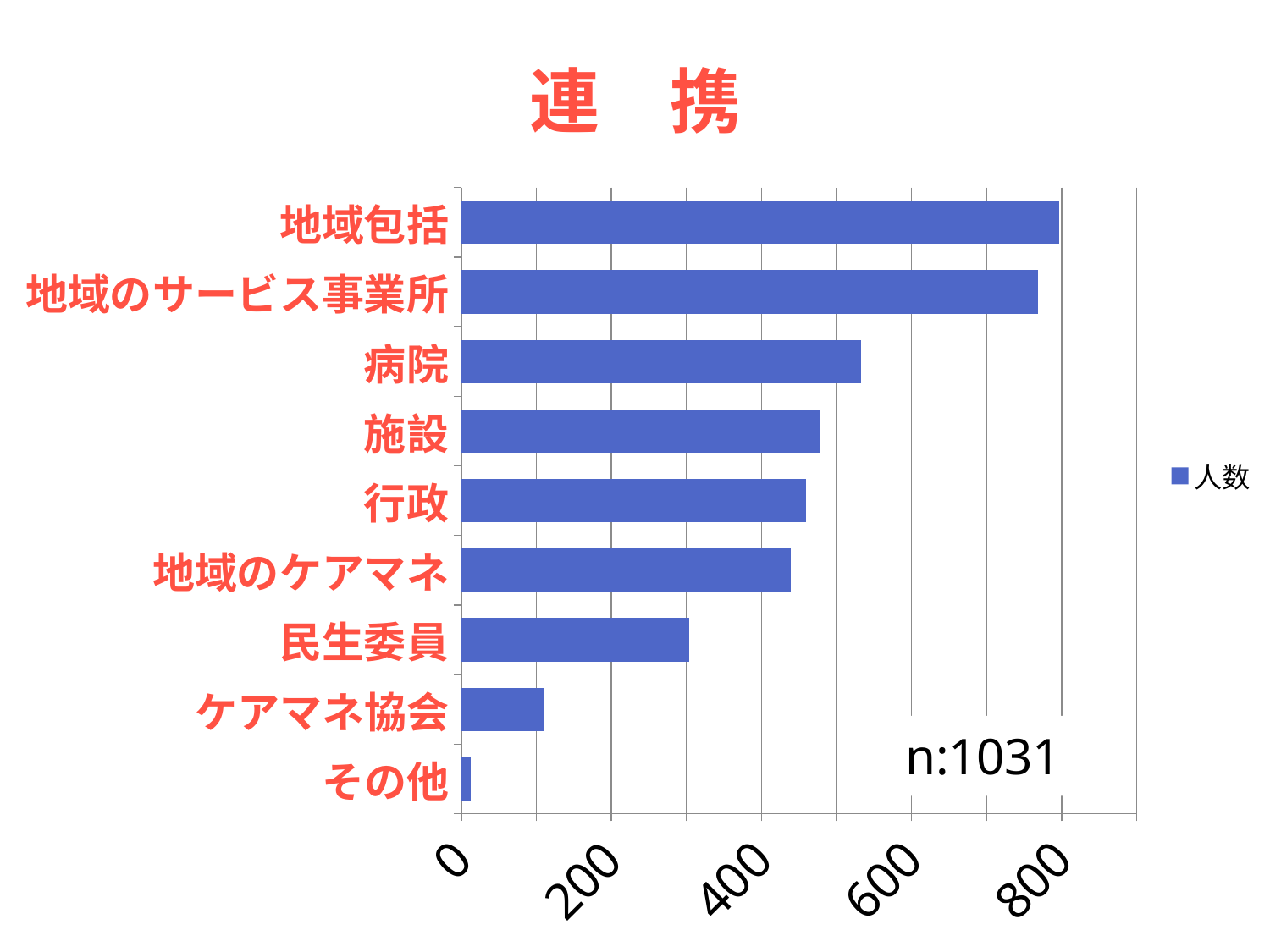
Is the value for 地域包括 greater or less than 600? greater Which has a larger value, 病院 or 民生委員? 病院 Which category has the highest value? 地域包括 How many series does the legend list? 1 What is the name of the series shown in the legend? 人数 Is the value for 病院 greater or less than 400? greater Is the value for ケアマネ協会 greater or less than 200? less How many categories are plotted in the chart? 9 What is the title of the chart? 連 携 What kind of chart is shown on the slide? bar chart Which category has the lowest value? その他